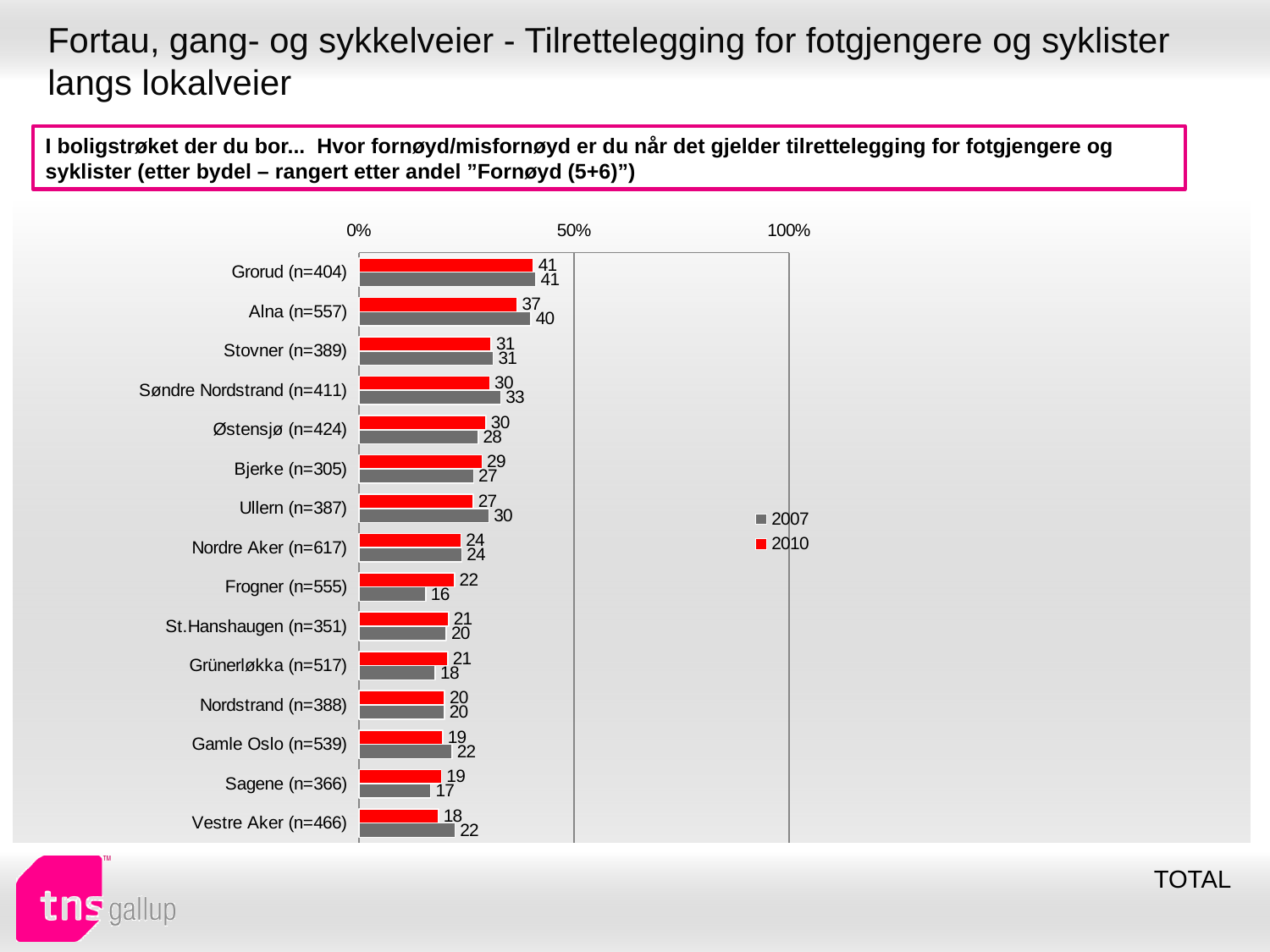
Is the 2010 value for Grorud (n=404) greater or less than 50%? less What is the difference between the 2010 and 2007 values for Frogner (n=555)? 6 How many districts are shown on the chart? 15 What kind of chart is shown on the slide? bar chart For Vestre Aker (n=466), which is larger: the 2007 value or the 2010 value? 2007 Which colour represents the 2010 series? red What is the 2007 value for Frogner (n=555)? 16 What is the 2007 value for Alna (n=557)? 40 How many series does the legend list? 2 What is the 2010 value for Grorud (n=404)? 41 Which district has the lowest 2010 value? Vestre Aker (n=466) Which district has the highest 2010 value? Grorud (n=404)